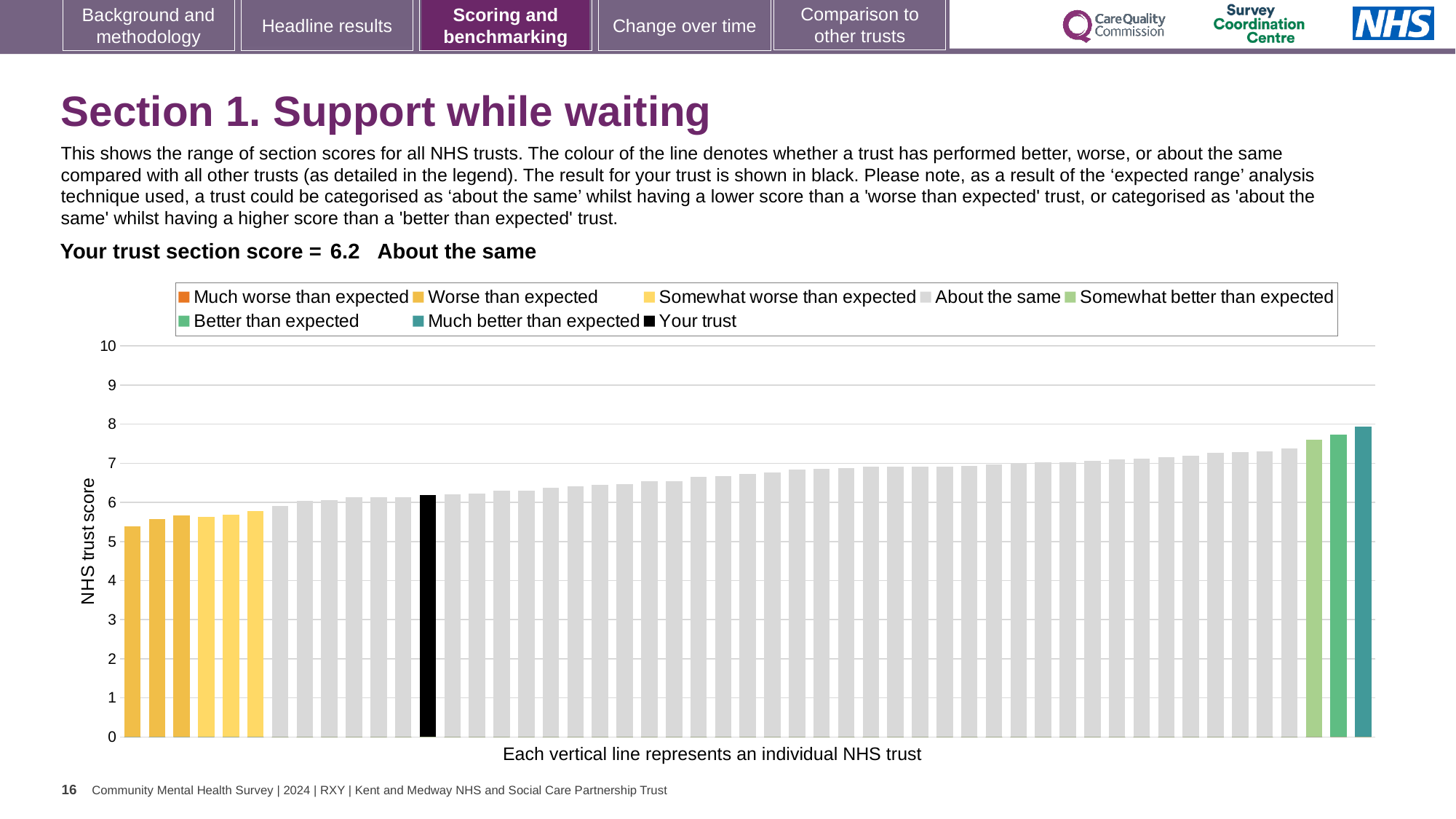
Do the bar values rise or fall from left to right along the x axis? rise What is the section score for your trust shown on the slide? 6.2 What colour is the bar representing your trust? black What is the label on the vertical axis of the chart? NHS trust score How many entries does the chart legend list? 8 Is the value of the shortest bar greater or less than 6? less Which is larger, the rightmost bar or the bar for your trust? the rightmost bar Which performance category is your trust placed in for this section? About the same Which legend category does the tallest bar belong to? Much better than expected What kind of chart is shown on the slide? bar chart Is the value for your trust greater or less than 5? greater Is the value of the tallest bar greater or less than 7? greater